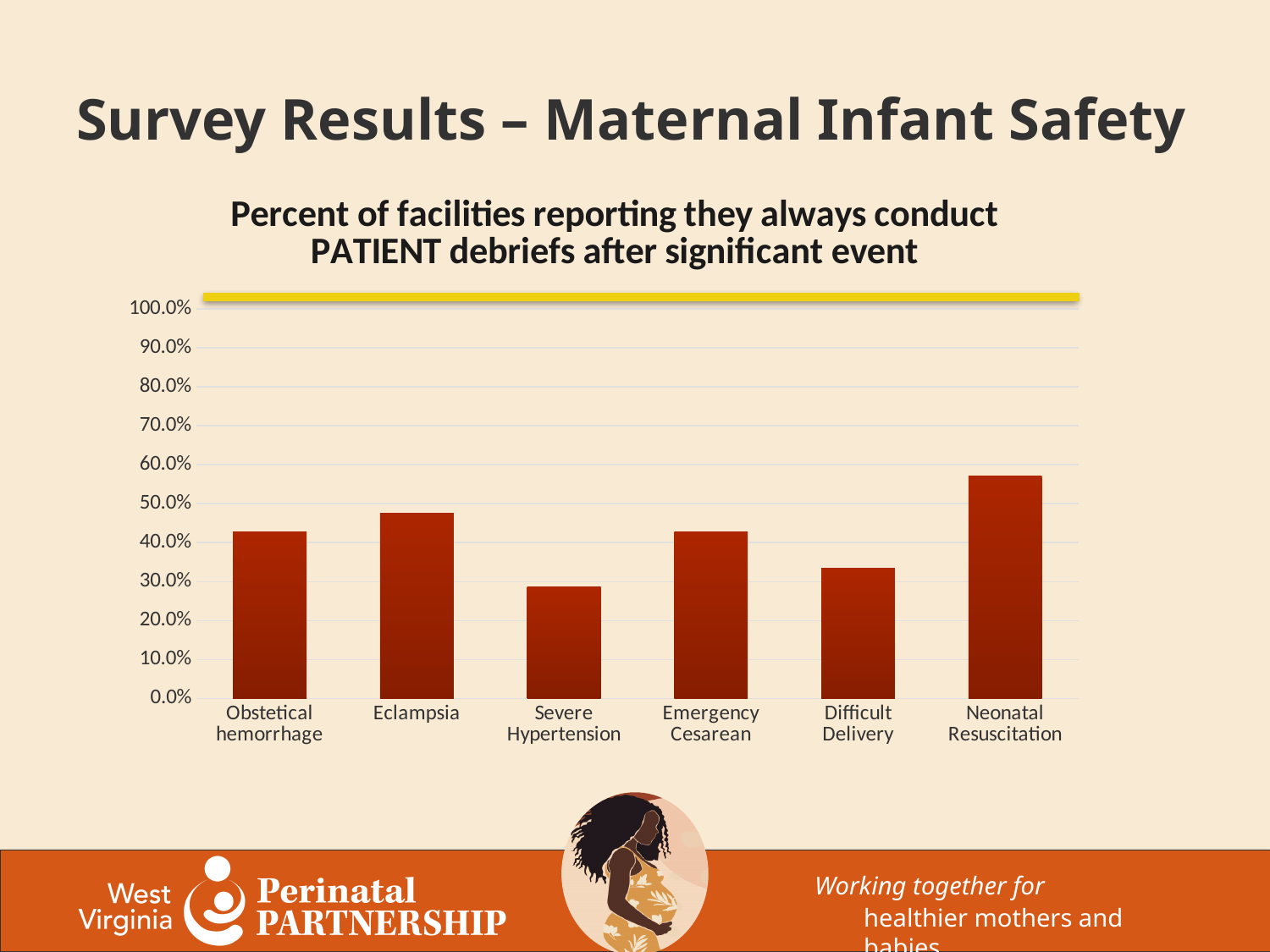
Which category has the highest percentage of facilities reporting they always conduct patient debriefs? Neonatal Resuscitation Which is larger, the value for Eclampsia or the value for Difficult Delivery? Eclampsia Is the value for Neonatal Resuscitation greater or less than 50.0%? greater How many categories are shown on the x axis of the chart? 6 Is the value for Obstetical hemorrhage greater or less than 40.0%? greater Which category has the lowest percentage of facilities reporting they always conduct patient debriefs? Severe Hypertension Which is larger, the value for Neonatal Resuscitation or the value for Emergency Cesarean? Neonatal Resuscitation What kind of chart is shown on the slide? bar chart Is the value for Severe Hypertension greater or less than 30.0%? less What is the title of the chart? Percent of facilities reporting they always conduct PATIENT debriefs after significant event